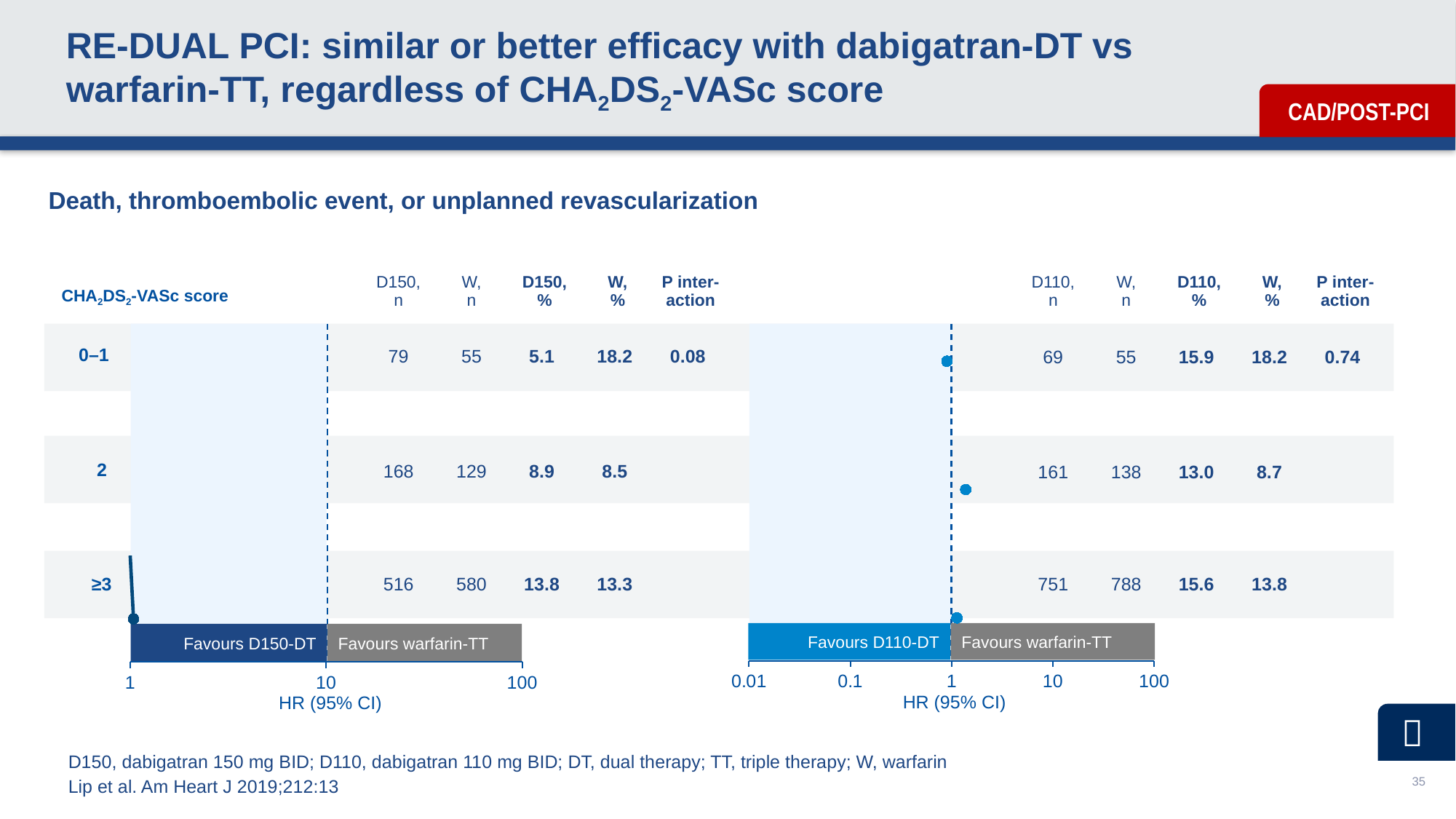
How many CHA2DS2-VASc score groups are shown in each chart? 3 In the right chart (D110 vs warfarin), what is the D110 event rate (%) for CHA2DS2-VASc score 2? 13.0 In the left chart (D150 vs warfarin), which CHA2DS2-VASc score group has the highest D150 event rate (%)? ≥3 In the left chart (D150 vs warfarin), what is the difference between the warfarin and D150 event rates (%) for CHA2DS2-VASc score 0–1? 13.1 In the right chart (D110 vs warfarin), is the plotted hazard ratio for CHA2DS2-VASc score 2 greater or less than 1? greater In the right chart (D110 vs warfarin), what is the P for interaction? 0.74 In the left chart (D150 vs warfarin), what is the warfarin event rate (%) for CHA2DS2-VASc score 0–1? 18.2 In the right chart (D110 vs warfarin), which CHA2DS2-VASc score group has the lowest warfarin event rate (%)? 2 In the left chart (D150 vs warfarin), what is the D150 event rate (%) for CHA2DS2-VASc score 0–1? 5.1 In the right chart (D110 vs warfarin), how many patients (n) were in the D110 group with CHA2DS2-VASc score ≥3? 751 In the left chart (D150 vs warfarin), what is the P for interaction? 0.08 In the right chart (D110 vs warfarin), is the D110 event rate (%) for score ≥3 larger or smaller than the warfarin event rate (%) for that group? larger